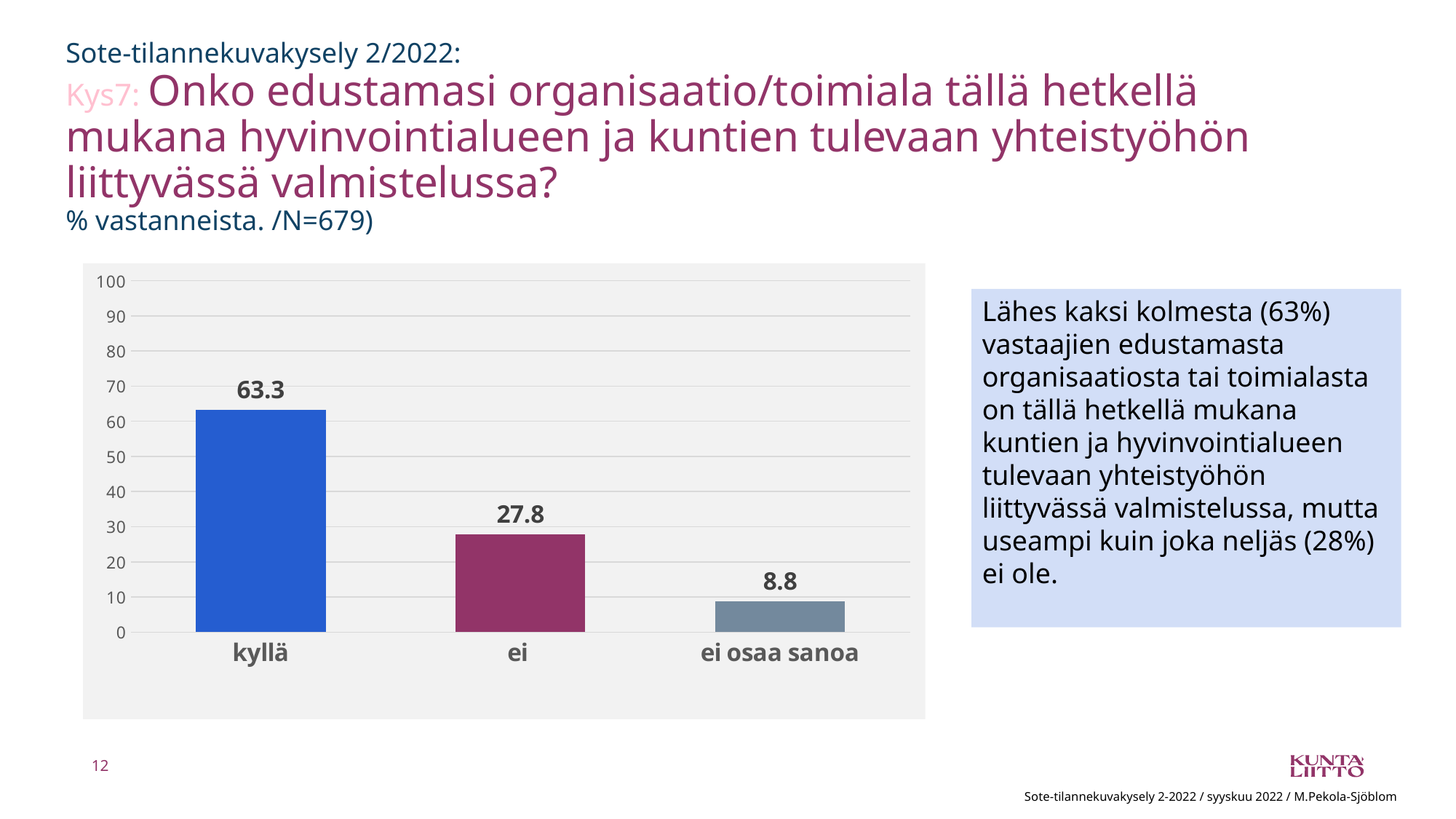
What is the colour of the bar for "ei"? purple What kind of chart is shown on the slide? bar chart What is the difference between the values for "ei" and "ei osaa sanoa"? 19.0 What is the difference between the values for "kyllä" and "ei"? 35.5 Which is larger, the value for "ei" or the value for "ei osaa sanoa"? ei What is the value for "ei osaa sanoa"? 8.8 What is the value for "ei"? 27.8 Is the value for "kyllä" greater or less than 50? greater What is the value for "kyllä"? 63.3 Which category has the highest value? kyllä Which category has the lowest value? ei osaa sanoa How many categories are shown in the chart? 3